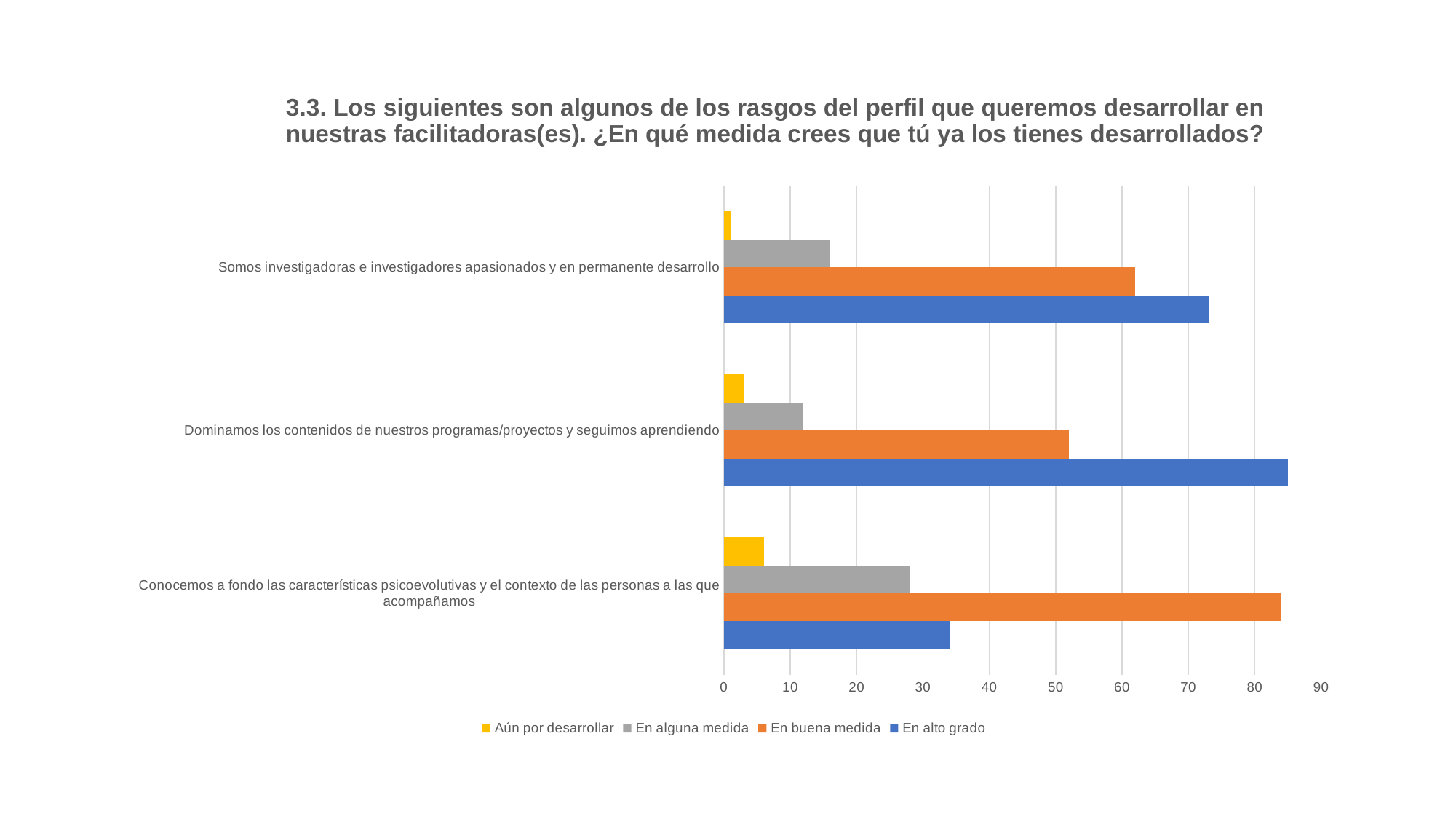
Which category has the lowest value for "En alto grado"? Conocemos a fondo las características psicoevolutivas y el contexto de las personas a las que acompañamos Is the "En alto grado" value for "Conocemos a fondo las características psicoevolutivas y el contexto de las personas a las que acompañamos" greater or less than 40? less Is the "En buena medida" value for "Somos investigadoras e investigadores apasionados y en permanente desarrollo" greater or less than 50? greater Is the "En alto grado" value for "Dominamos los contenidos de nuestros programas/proyectos y seguimos aprendiendo" greater or less than 80? greater How many categories (profile traits) are plotted on the chart? 3 Which colour represents the "En alto grado" series in the legend? blue Which category has the highest value for "En buena medida"? Conocemos a fondo las características psicoevolutivas y el contexto de las personas a las que acompañamos What kind of chart is shown on the slide? bar chart For "Somos investigadoras e investigadores apasionados y en permanente desarrollo", which is larger: "En alto grado" or "En buena medida"? En alto grado Which category has the highest value for "En alto grado"? Dominamos los contenidos de nuestros programas/proyectos y seguimos aprendiendo How many series does the legend list? 4